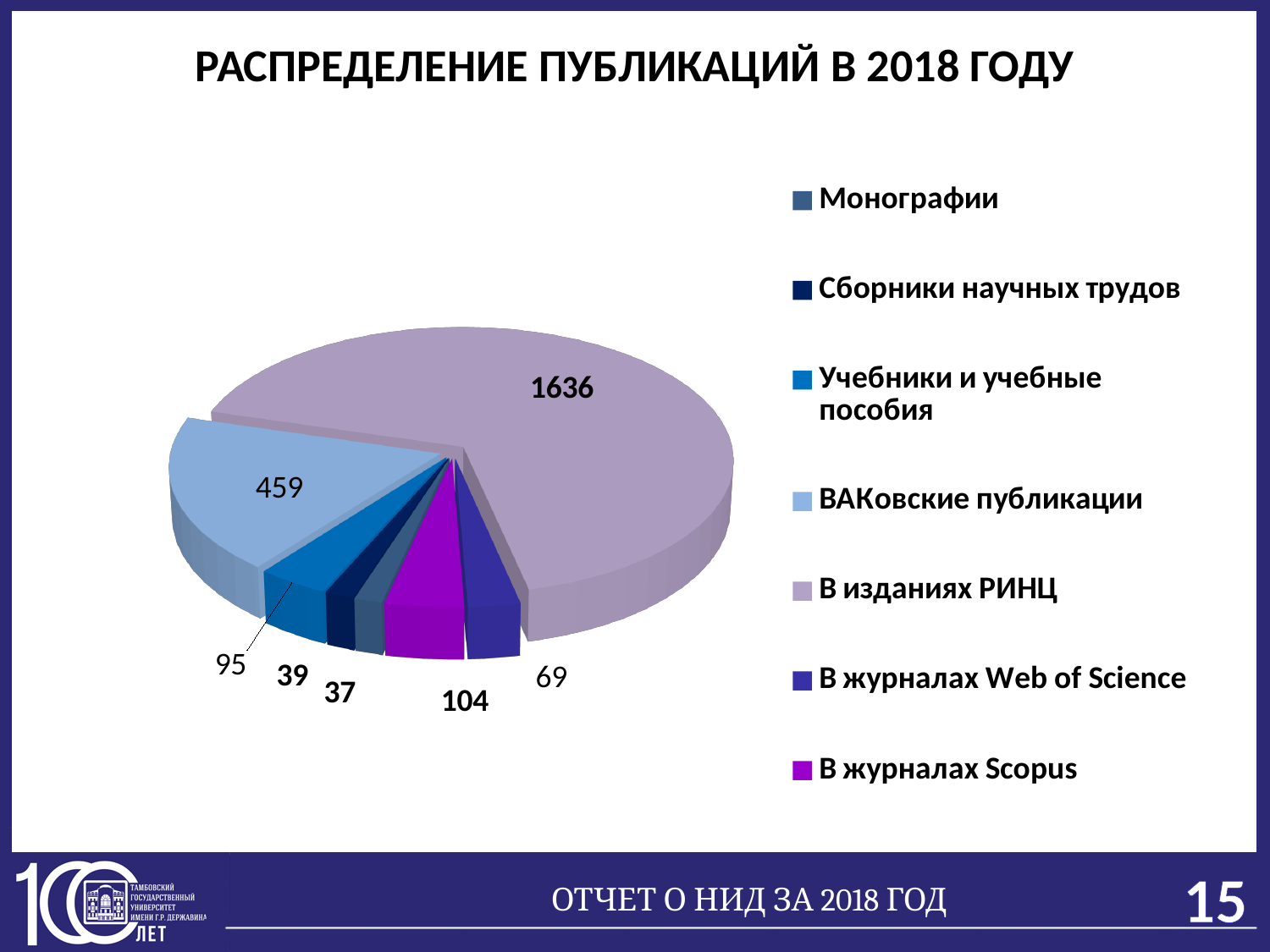
Which category has the smallest value? Монографии What is the value for В журналах Web of Science? 69 What is the value for ВАКовские публикации? 459 What is the title of the slide containing the chart? РАСПРЕДЕЛЕНИЕ ПУБЛИКАЦИЙ В 2018 ГОДУ What is the value for В журналах Scopus? 104 How many entries does the legend list? 7 What kind of chart is shown on the slide? Pie chart What is the value for В изданиях РИНЦ? 1636 Which is larger, the value for В журналах Scopus or the value for Учебники и учебные пособия? В журналах Scopus Which category has the largest slice of the pie? В изданиях РИНЦ How many slices does the pie chart have? 7 What is the difference between the values for В изданиях РИНЦ and ВАКовские публикации? 1177